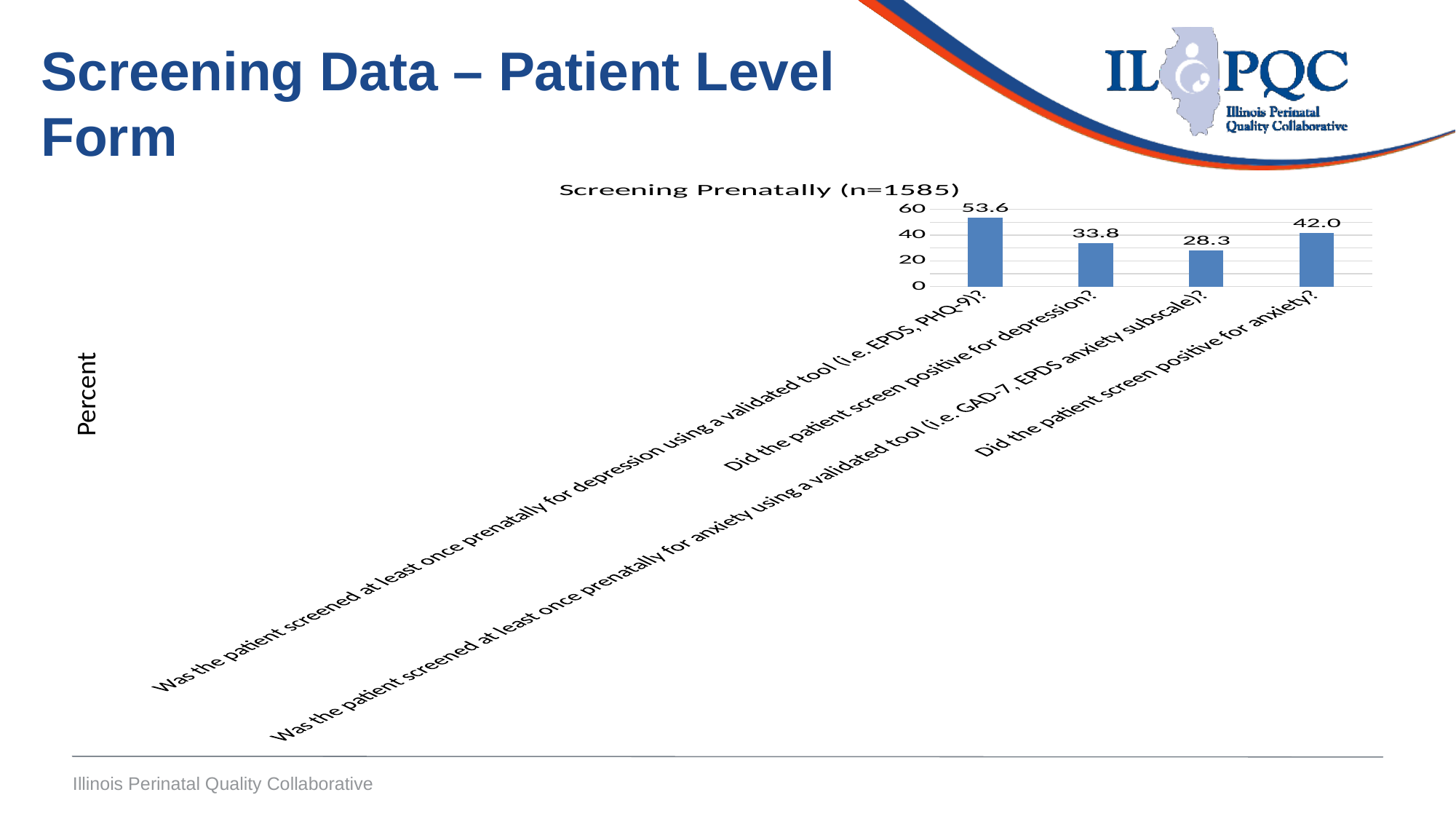
How many categories are shown in the chart? 4 What is the label of the vertical axis? Percent Which is larger: the value for 'Did the patient screen positive for anxiety?' or the value for 'Did the patient screen positive for depression?' Did the patient screen positive for anxiety? What is the title of the chart? Screening Prenatally (n=1585) What is the value for 'Was the patient screened at least once prenatally for anxiety using a validated tool (i.e. GAD-7, EPDS anxiety subscale)?' 28.3 What is the value for 'Did the patient screen positive for anxiety?' 42.0 What is the value for 'Was the patient screened at least once prenatally for depression using a validated tool (i.e. EPDS, PHQ-9)?' 53.6 What kind of chart is shown on the slide? Bar chart What is the value for 'Did the patient screen positive for depression?' 33.8 Which category has the highest value? Was the patient screened at least once prenatally for depression using a validated tool (i.e. EPDS, PHQ-9)? What is the difference between the value for screening for depression with a validated tool and the value for screening positive for depression? 19.8 Which category has the lowest value? Was the patient screened at least once prenatally for anxiety using a validated tool (i.e. GAD-7, EPDS anxiety subscale)?